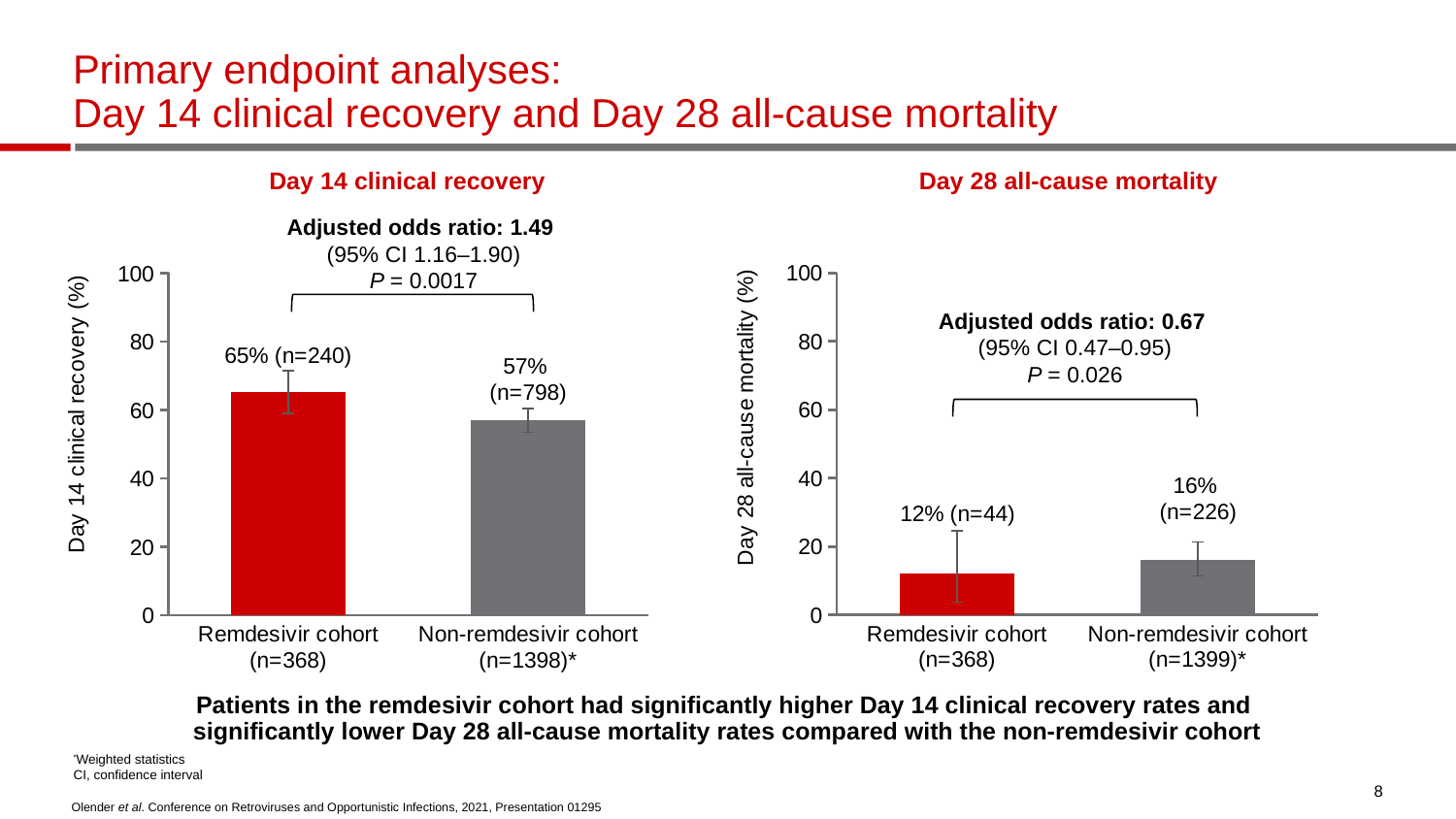
How many bars are shown in the Day 14 clinical recovery chart? 2 In the Day 14 clinical recovery chart, what is the difference between the Remdesivir cohort and the Non-remdesivir cohort values? 8% In the Day 28 all-cause mortality chart, which cohort has the lower value? Remdesivir cohort What kind of chart is the Day 28 all-cause mortality chart? Bar chart In the Day 28 all-cause mortality chart, what is the value for the Non-remdesivir cohort? 16% In the Day 14 clinical recovery chart, what is the value for the Remdesivir cohort? 65% In the Day 28 all-cause mortality chart, is the value for the Non-remdesivir cohort greater or less than 20? less In the Day 28 all-cause mortality chart, what is the value for the Remdesivir cohort? 12% In the Day 14 clinical recovery chart, what is the value for the Non-remdesivir cohort? 57% In the Day 14 clinical recovery chart, which cohort has the higher value? Remdesivir cohort What is the adjusted odds ratio shown on the Day 28 all-cause mortality chart? 0.67 In the Day 28 all-cause mortality chart, what is the difference between the Non-remdesivir cohort and the Remdesivir cohort values? 4%